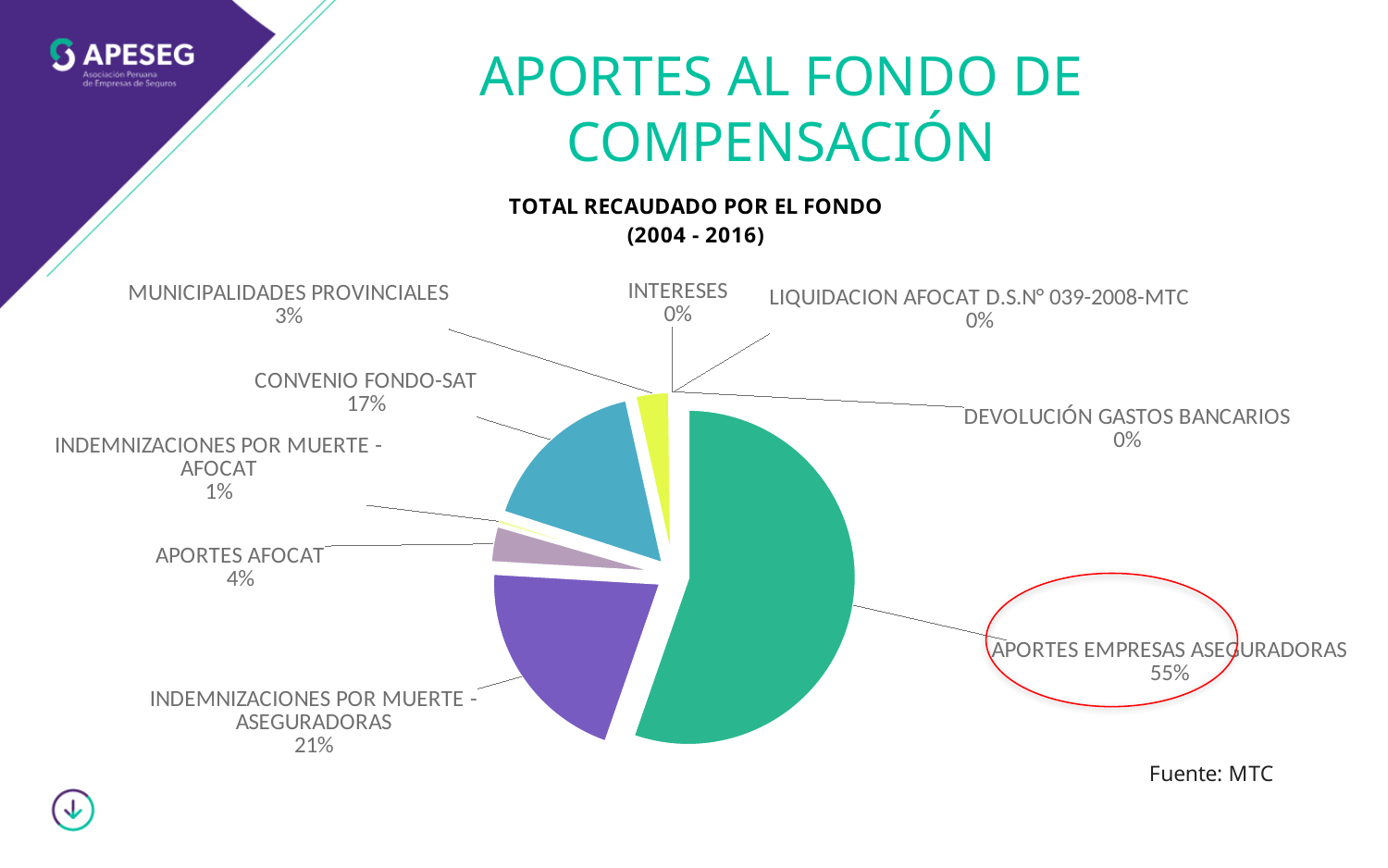
What is the value shown for MUNICIPALIDADES PROVINCIALES? 3% Which category has the largest share of the pie? APORTES EMPRESAS ASEGURADORAS Which is larger, the share for CONVENIO FONDO-SAT or the share for APORTES AFOCAT? CONVENIO FONDO-SAT What is the title of the chart? TOTAL RECAUDADO POR EL FONDO (2004 - 2016) What is the difference between the shares of APORTES EMPRESAS ASEGURADORAS and INDEMNIZACIONES POR MUERTE - ASEGURADORAS? 34% What is the value shown for CONVENIO FONDO-SAT? 17% What is the value shown for APORTES AFOCAT? 4% What share of the pie does APORTES EMPRESAS ASEGURADORAS represent? 55% What kind of chart is shown on the slide? Pie chart What is the value shown for INDEMNIZACIONES POR MUERTE - AFOCAT? 1% What is the value shown for INDEMNIZACIONES POR MUERTE - ASEGURADORAS? 21% How many categories are labelled on the pie chart? 9